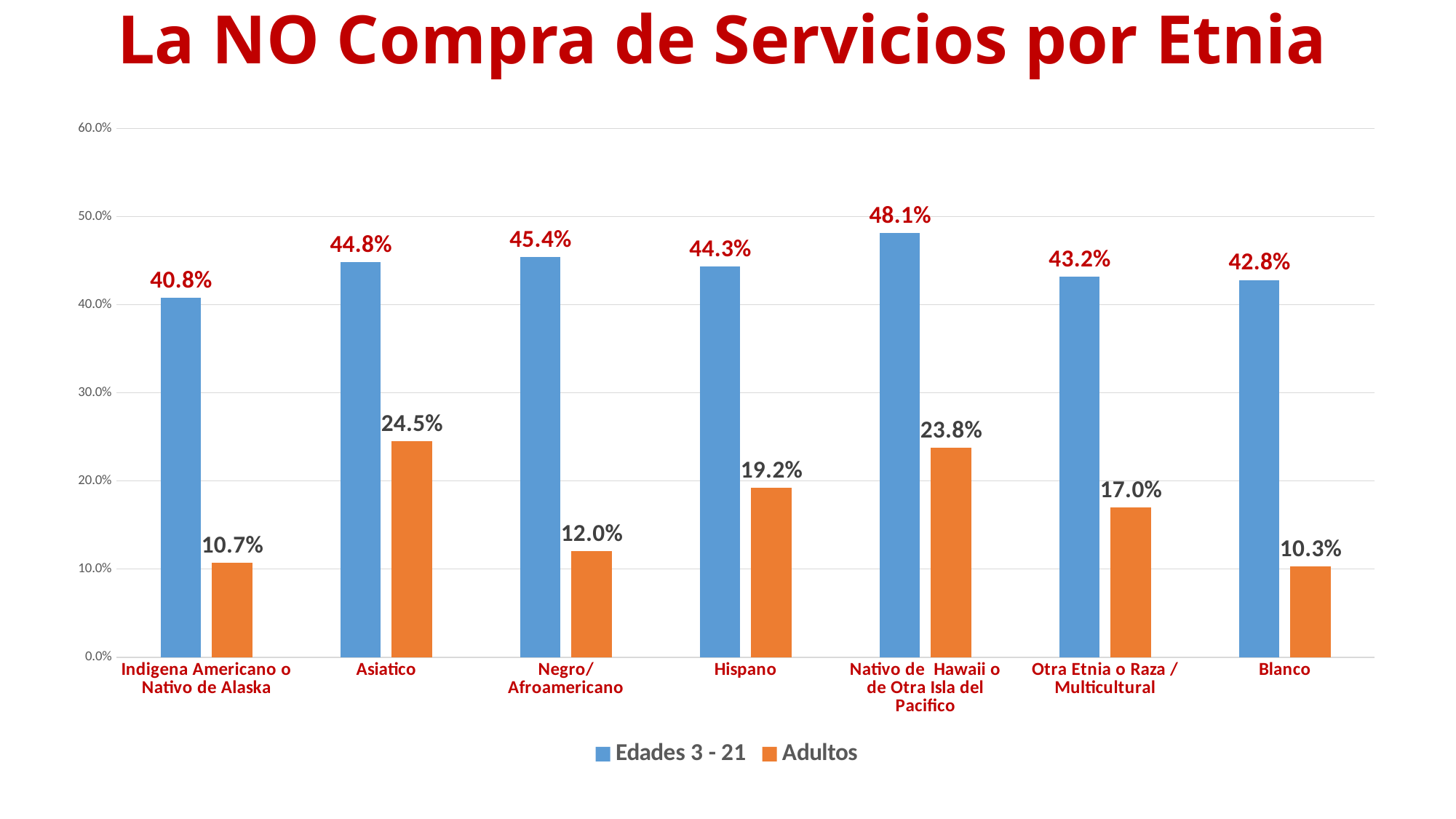
Which category has the highest value for Edades 3 - 21? Nativo de Hawaii o de Otra Isla del Pacifico What is the value for Adultos for Blanco? 10.3% Is the Adultos value for Nativo de Hawaii o de Otra Isla del Pacifico greater or less than 20.0%? greater What is the difference between the Edades 3 - 21 and Adultos values for Negro/Afroamericano? 33.4% What is the value for Adultos for Asiatico? 24.5% What is the value for Edades 3 - 21 for Hispano? 44.3% How many series does the legend list? 2 How many categories are shown on the x axis? 7 Which is larger: the Adultos value for Hispano or the Adultos value for Otra Etnia o Raza / Multicultural? Hispano Which category has the highest value for Adultos? Asiatico What kind of chart is shown on the slide? bar chart Which category has the lowest value for Edades 3 - 21? Indigena Americano o Nativo de Alaska